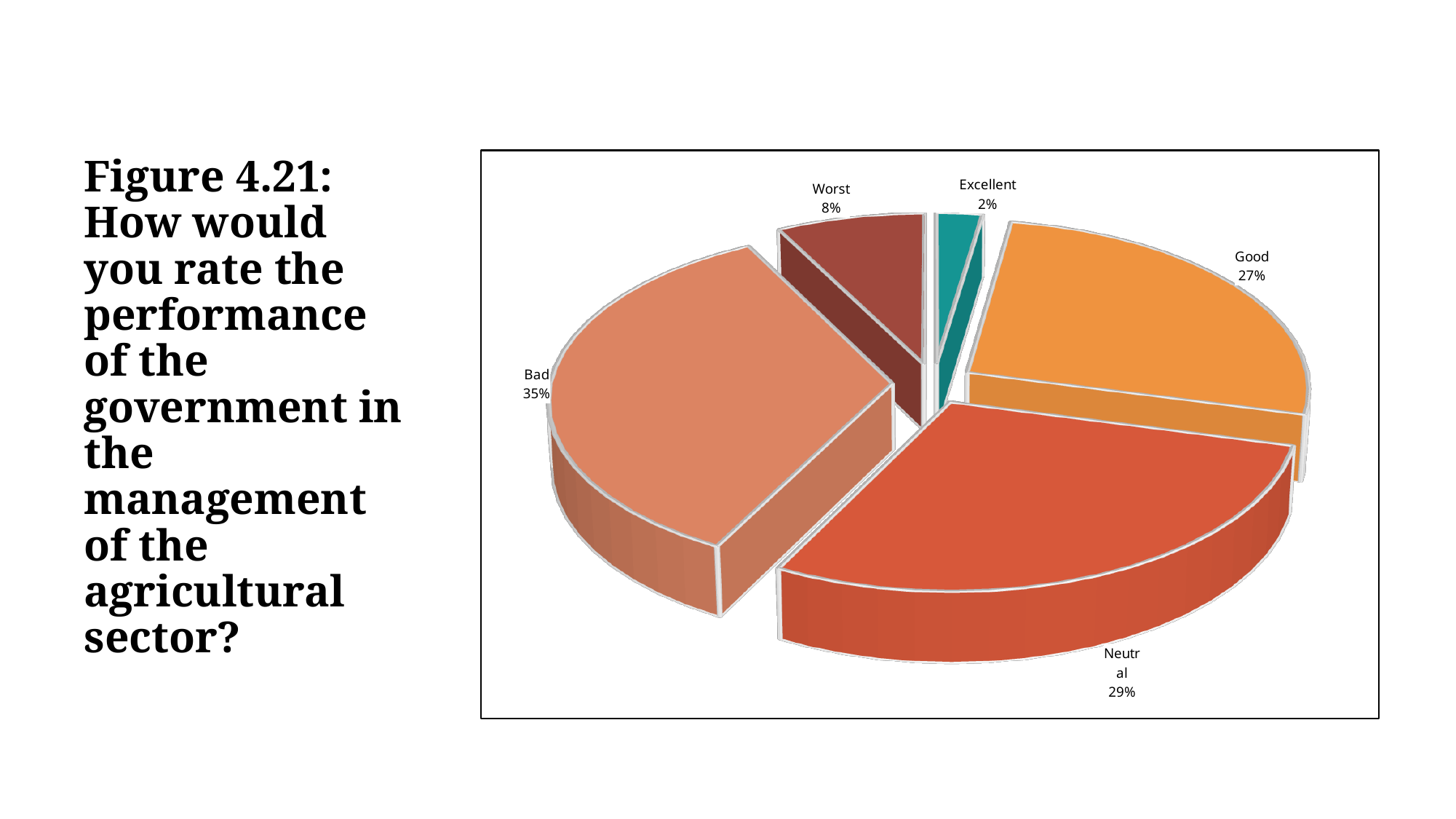
What percentage of respondents rated the performance as Excellent? 2% What percentage of respondents rated the performance as Worst? 8% What percentage of respondents gave a Neutral rating? 29% What kind of chart is shown on the slide? pie chart Which is larger, the Neutral slice or the Good slice? Neutral What percentage of respondents rated the government's performance as Bad? 35% What is the difference in percentage points between the Bad and Good slices? 8 Which rating category has the largest share of the pie? Bad How many rating categories are shown in the pie chart? 5 Which rating category has the smallest share of the pie? Excellent What is the combined percentage of the Worst and Excellent slices? 10% What percentage of respondents rated the government's performance as Good? 27%